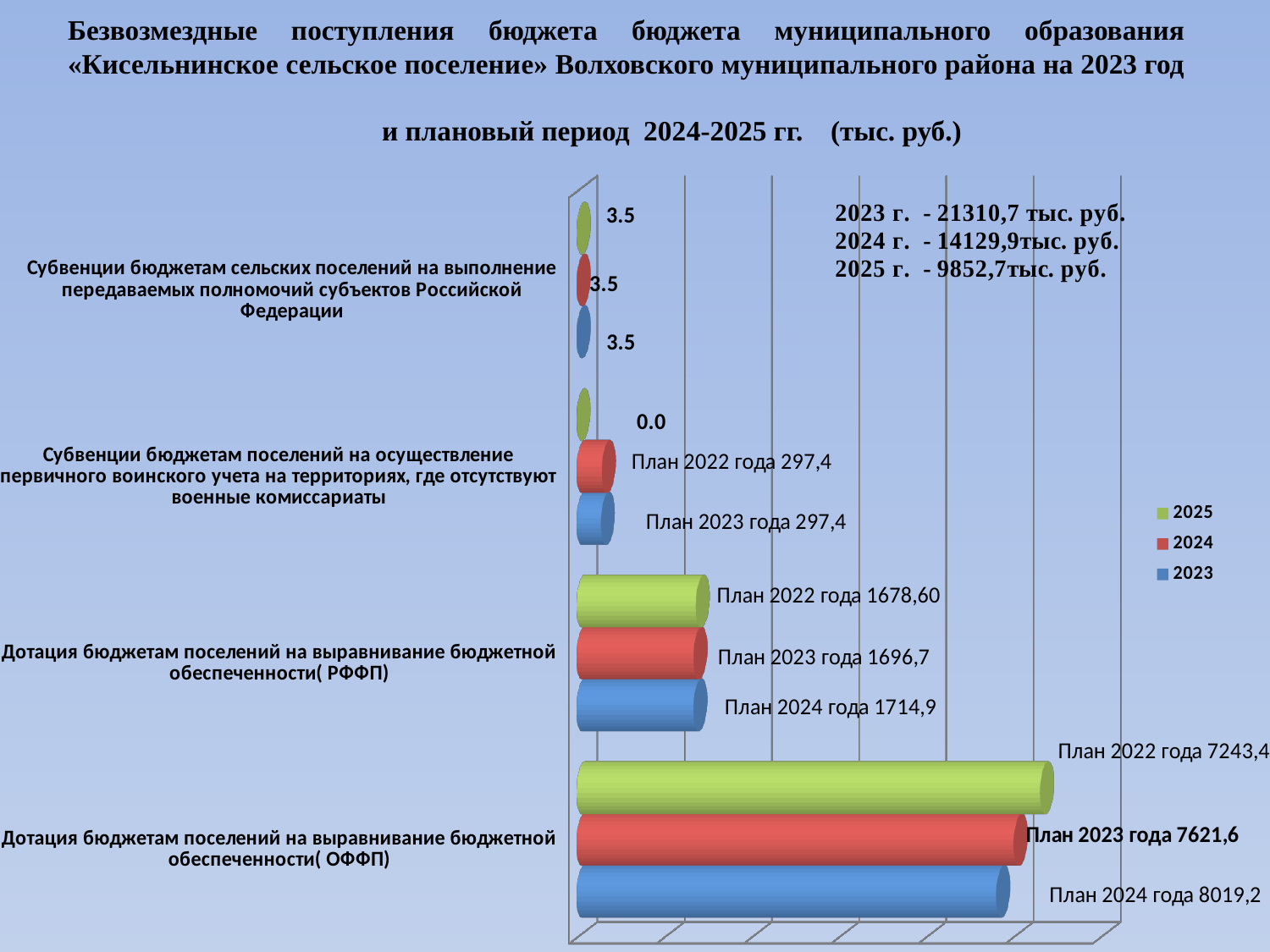
What type of chart is shown on the slide? bar chart What entries are listed in the chart legend? 2025, 2024, 2023 For the РФФП category, what is the difference between the blue bar value (1714,9) and the red bar value (1696,7)? 18,2 Which category has the longest bars on the chart? Дотация бюджетам поселений на выравнивание бюджетной обеспеченности (ОФФП) What value is printed next to the red bar for «Дотация бюджетам поселений на выравнивание бюджетной обеспеченности (ОФФП)»? 7621,6 What value is printed next to the green bar for «Субвенции бюджетам поселений на осуществление первичного воинского учета»? 0.0 For the ОФФП category, which bar is longer: the blue one or the green one? the green one What value is printed next to the blue bar for «Дотация бюджетам поселений на выравнивание бюджетной обеспеченности (ОФФП)»? 8019,2 What value is printed next to the green bar for «Дотация бюджетам поселений на выравнивание бюджетной обеспеченности (РФФП)»? 1678,60 How many categories are plotted on the chart? 4 How many series does the chart legend list? 3 For the ОФФП category, what is the difference between the blue bar value (8019,2) and the green bar value (7243,4)? 775,8